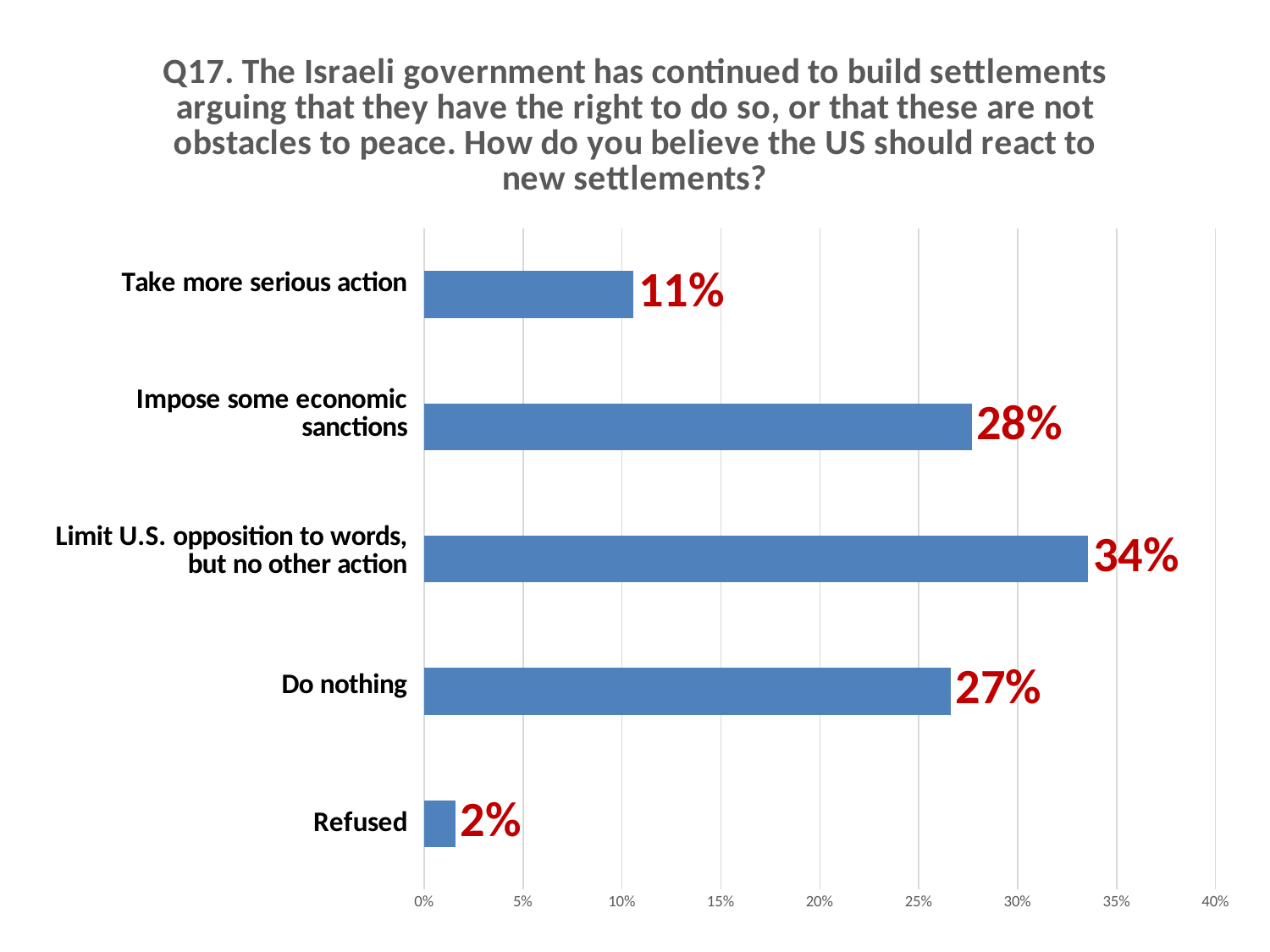
What is the maximum value shown on the horizontal axis? 40% What percentage chose "Do nothing"? 27% What is the value for "Refused"? 2% What is the value for "Impose some economic sanctions"? 28% Is the value for "Take more serious action" greater or less than 15%? less How many response categories are shown in the chart? 5 Which is larger: "Impose some economic sanctions" or "Do nothing"? Impose some economic sanctions What type of chart is shown on the slide? Bar chart Which response option has the lowest percentage? Refused Which response option has the highest percentage? Limit U.S. opposition to words, but no other action What is the difference between "Limit U.S. opposition to words, but no other action" and "Take more serious action"? 23% What percentage of respondents chose "Take more serious action"? 11%